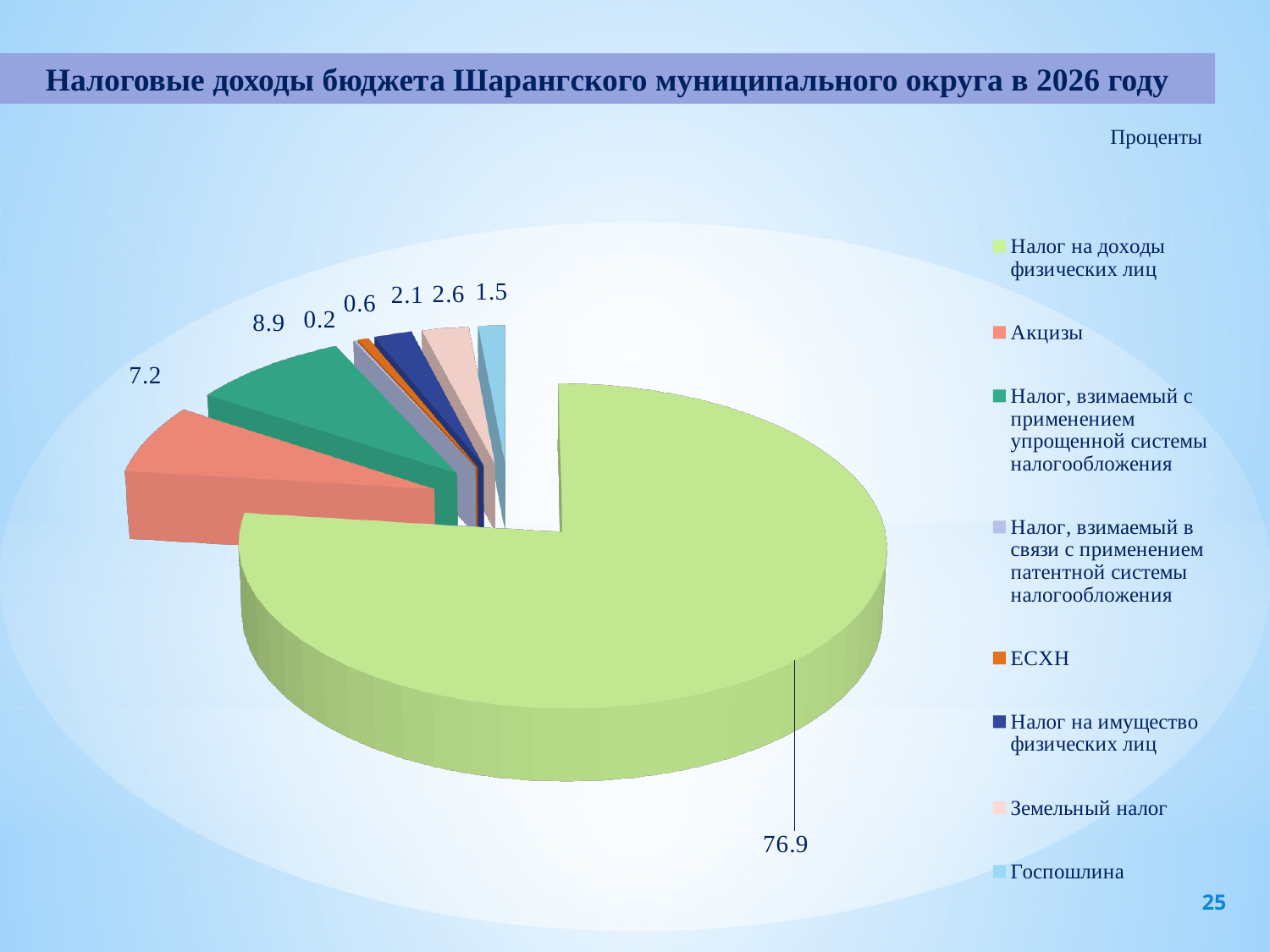
What is the value shown for Госпошлина? 1.5 How many slices does the pie chart have? 8 What is the difference between the values for Земельный налог and Налог на имущество физических лиц? 0.5 What is the value shown for Акцизы? 7.2 What is the value shown for Налог, взимаемый с применением упрощенной системы налогообложения? 8.9 What unit is indicated for the values in the chart? Проценты Which category has the largest share of the pie? Налог на доходы физических лиц What kind of chart is shown on the slide? pie chart What is the value shown for Налог на доходы физических лиц? 76.9 What is the value shown for ЕСХН? 0.6 Which is larger: the value for Земельный налог or the value for Госпошлина? Земельный налог Which category has the smallest share of the pie? Налог, взимаемый в связи с применением патентной системы налогообложения